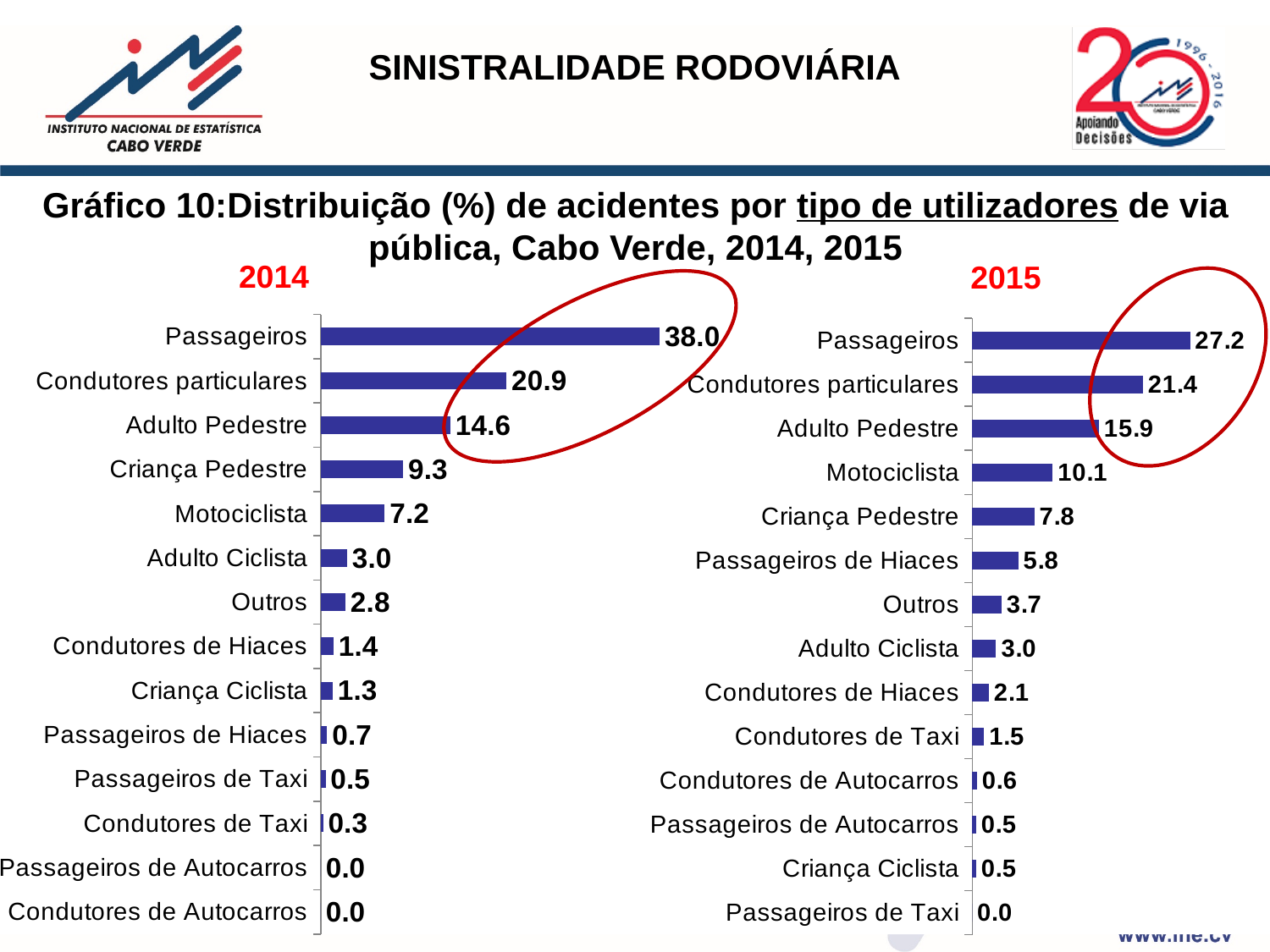
In the 2014 chart, what is the value for Passageiros? 38.0 In the 2015 chart, which category has the lowest value? Passageiros de Taxi Which three categories are circled in red in the 2015 chart? Passageiros, Condutores particulares, Adulto Pedestre How many categories are shown in the 2015 chart? 14 In the 2014 chart, what is the value for Criança Pedestre? 9.3 In the 2015 chart, what is the value for Passageiros de Hiaces? 5.8 In the 2014 chart, which is larger: Motociclista or Adulto Ciclista? Motociclista In the 2015 chart, what is the difference between Adulto Pedestre and Criança Pedestre? 8.1 In the 2015 chart, what is the value for Motociclista? 10.1 In the 2015 chart, which category has the highest value? Passageiros In the 2014 chart, what is the difference between Passageiros and Condutores particulares? 17.1 What kind of chart is the 2014 chart? Bar chart